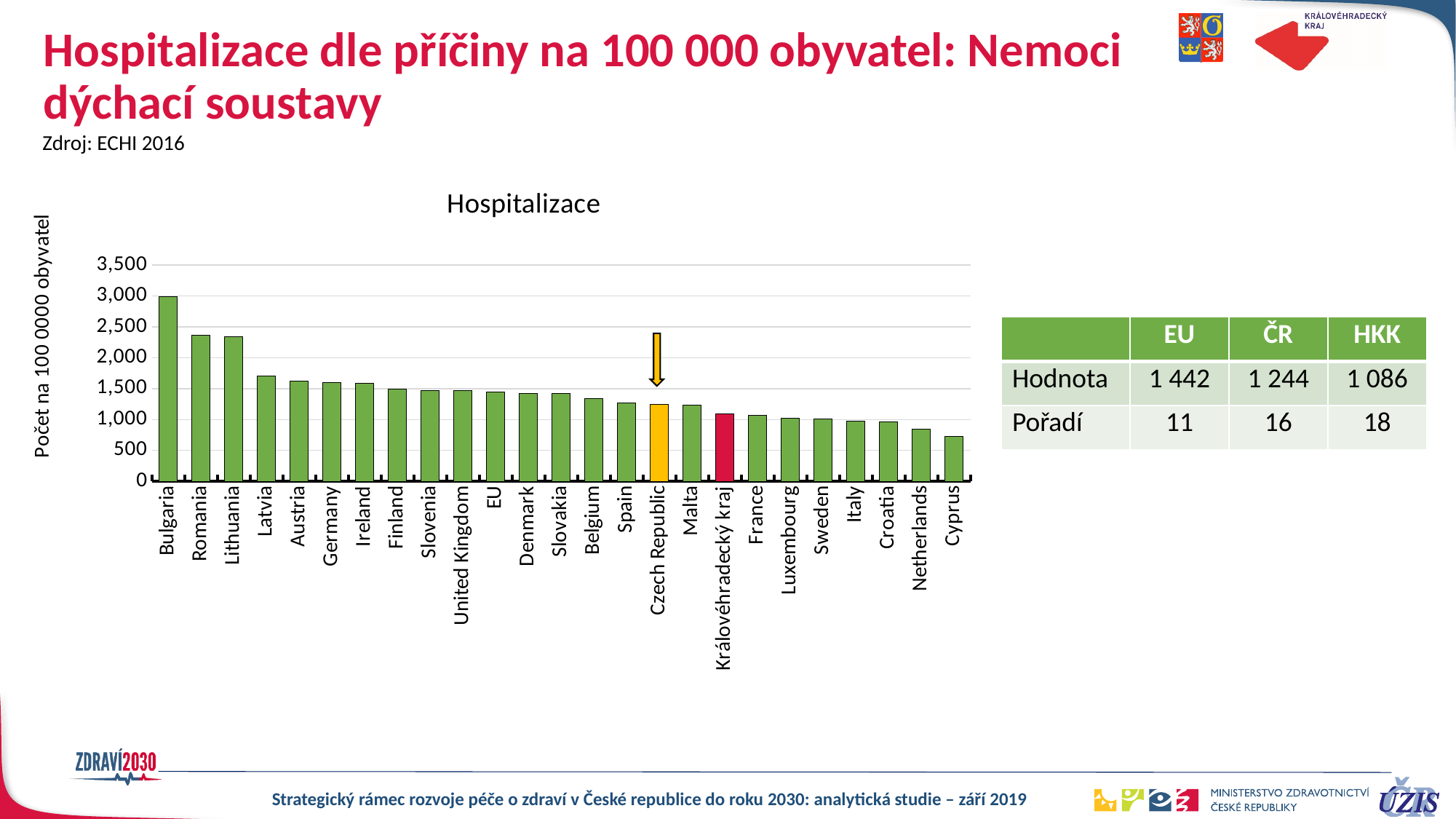
Which country has the lowest hospitalization rate in the chart? Cyprus What is the value for EU according to the table on the slide? 1 442 Do the bar values rise or fall from left to right along the x axis? fall What is the value for ČR (Czech Republic) according to the table on the slide? 1 244 Is the value for Bulgaria greater or less than 2,500? greater How many bars (categories) are plotted in the chart? 25 Is the value for Cyprus greater or less than 1,000? less What is the difference between the EU value and the ČR value shown in the table? 198 What is the value for HKK (Královéhradecký kraj) according to the table on the slide? 1 086 Which country has the highest hospitalization rate in the chart? Bulgaria Which is larger, the value for Romania or the value for Latvia? Romania What type of chart is shown on the slide? bar chart